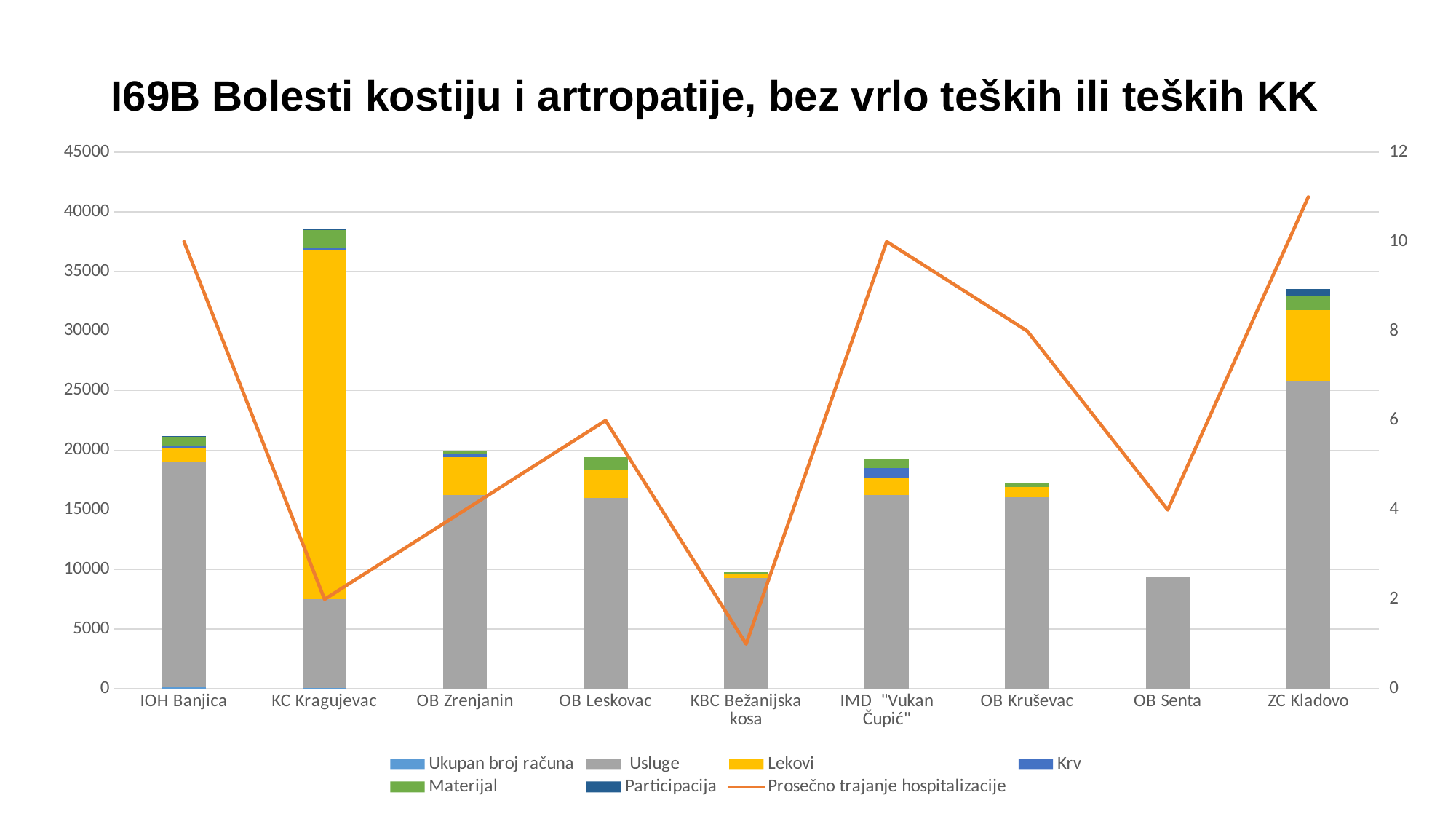
Which hospital has the tallest stacked bar? KC Kragujevac Is the total stacked bar for KC Kragujevac greater or less than 35000? greater Which hospital has the lowest value on the Prosečno trajanje hospitalizacije line? KBC Bežanijska kosa What is the Prosečno trajanje hospitalizacije value for OB Senta on the right axis? 4 Is the total stacked bar for OB Senta greater or less than 10000? less Is the total stacked bar for ZC Kladovo greater or less than 30000? greater What kind of chart is shown on the slide? A combination chart of stacked bars and a line What is the title of the chart? I69B Bolesti kostiju i artropatije, bez vrlo teških ili teških KK Which has the larger total stacked bar, IOH Banjica or KC Kragujevac? KC Kragujevac How many series does the legend list? 7 Which hospital has the highest value on the Prosečno trajanje hospitalizacije line? ZC Kladovo How many hospitals (categories) are shown on the x axis? 9